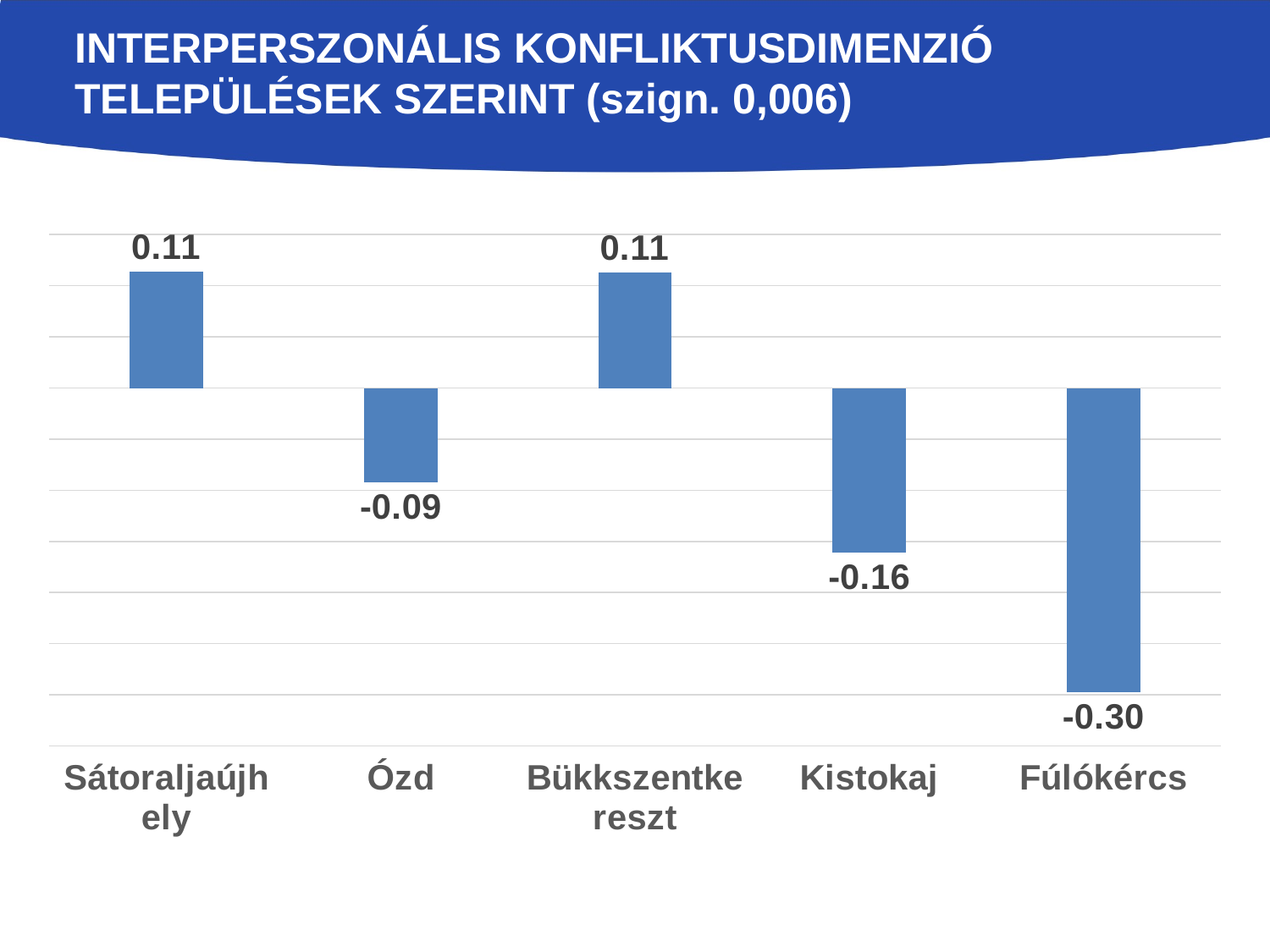
What is the value for Bükkszentkereszt? 0.11 What kind of chart is shown on the slide? Bar chart Which settlement has the lowest value? Fúlókércs What is the value for Sátoraljaújhely? 0.11 What is the difference between the values for Sátoraljaújhely and Fülókércs? 0.41 What is the value for Ózd? -0.09 What is the value for Fülókércs? -0.30 How many settlements are shown in the chart? 5 What significance value is given in the chart title? 0,006 What is the difference between the values for Ózd and Kistokaj? 0.07 What is the value for Kistokaj? -0.16 Which has the larger value, Ózd or Kistokaj? Ózd